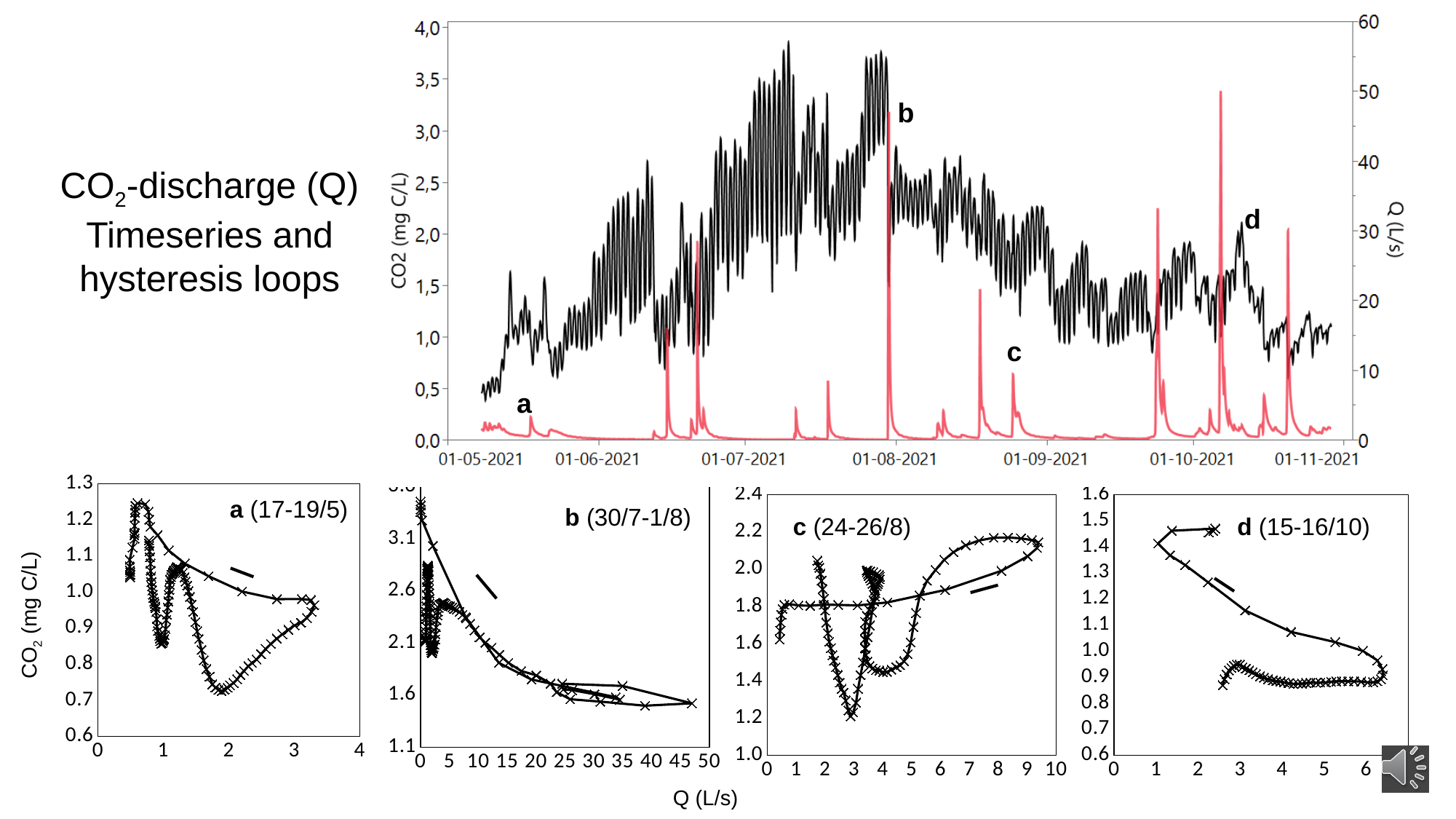
What kind of chart is the large chart at the top of the slide? line chart In the top timeseries chart, what colour is the discharge (Q) line? red In the top timeseries chart, is the highest CO2 value reached greater or less than 3.5 mg C/L? greater In hysteresis loop c, is the lowest CO2 value greater or less than 1.4 mg C/L? less In hysteresis loop d, is the highest CO2 value greater or less than 1.4 mg C/L? greater Which date range is given for hysteresis loop b? 30/7-1/8 How many hysteresis loop charts are shown along the bottom of the slide? 4 In the top timeseries chart, what is the label of the right-hand y axis? Q (L/s)